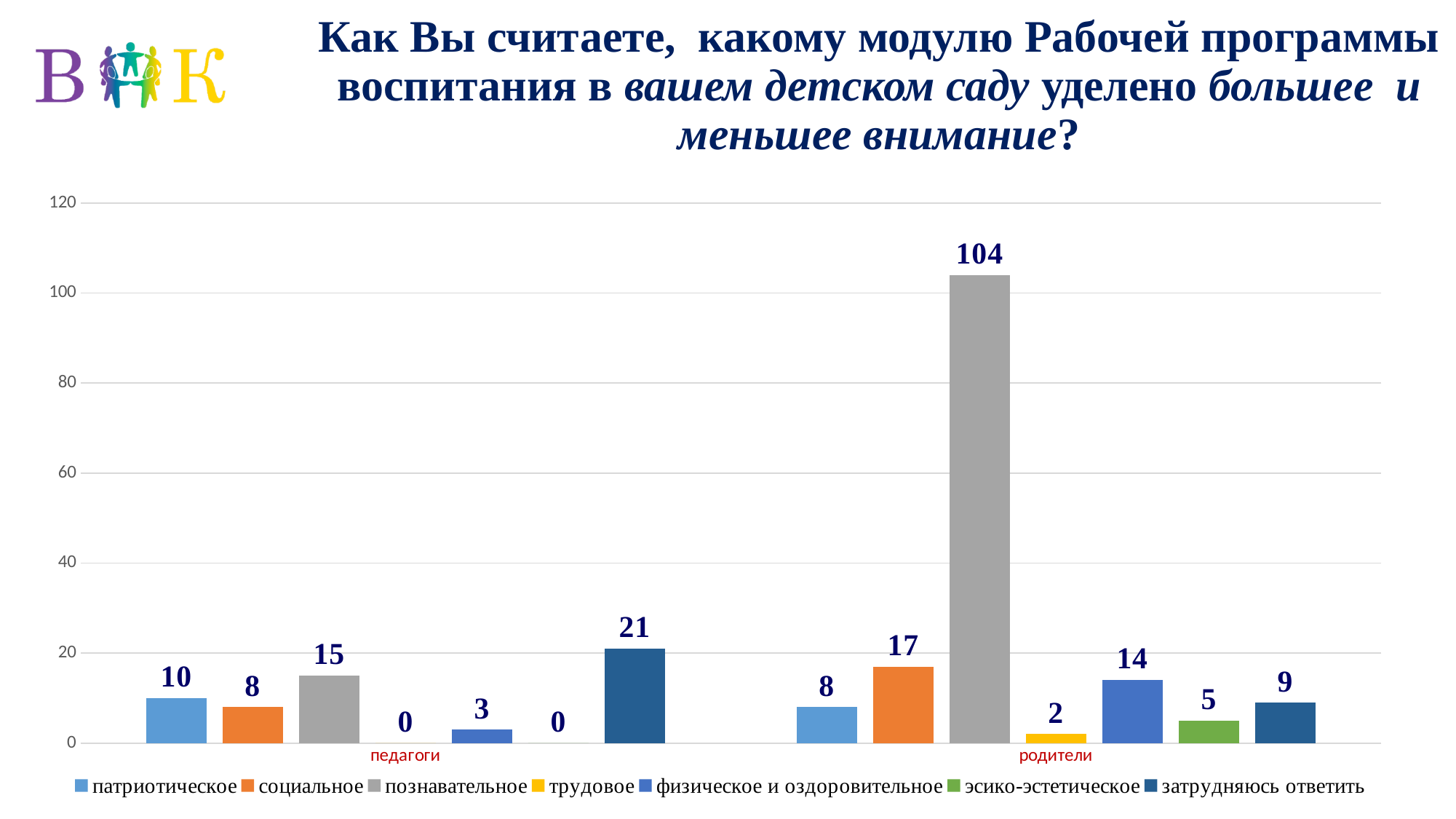
What kind of chart is shown on the slide? bar chart How many groups of bars are shown on the x axis? 2 Which series has the highest value in the "педагоги" group? затрудняюсь ответить What is the difference between the "познавательное" values for "родители" and "педагоги"? 89 How many series does the legend list? 7 Is the value for "познавательное" in the "родители" group greater or less than 100? greater Which series has the lowest value in the "родители" group? трудовое What is the value for "физическое и оздоровительное" in the "родители" group? 14 What colour are the bars for the "познавательное" series? grey What is the value for "познавательное" in the "родители" group? 104 Which is larger: "социальное" for "педагоги" or "социальное" for "родители"? родители What is the value for "затрудняюсь ответить" in the "педагоги" group? 21